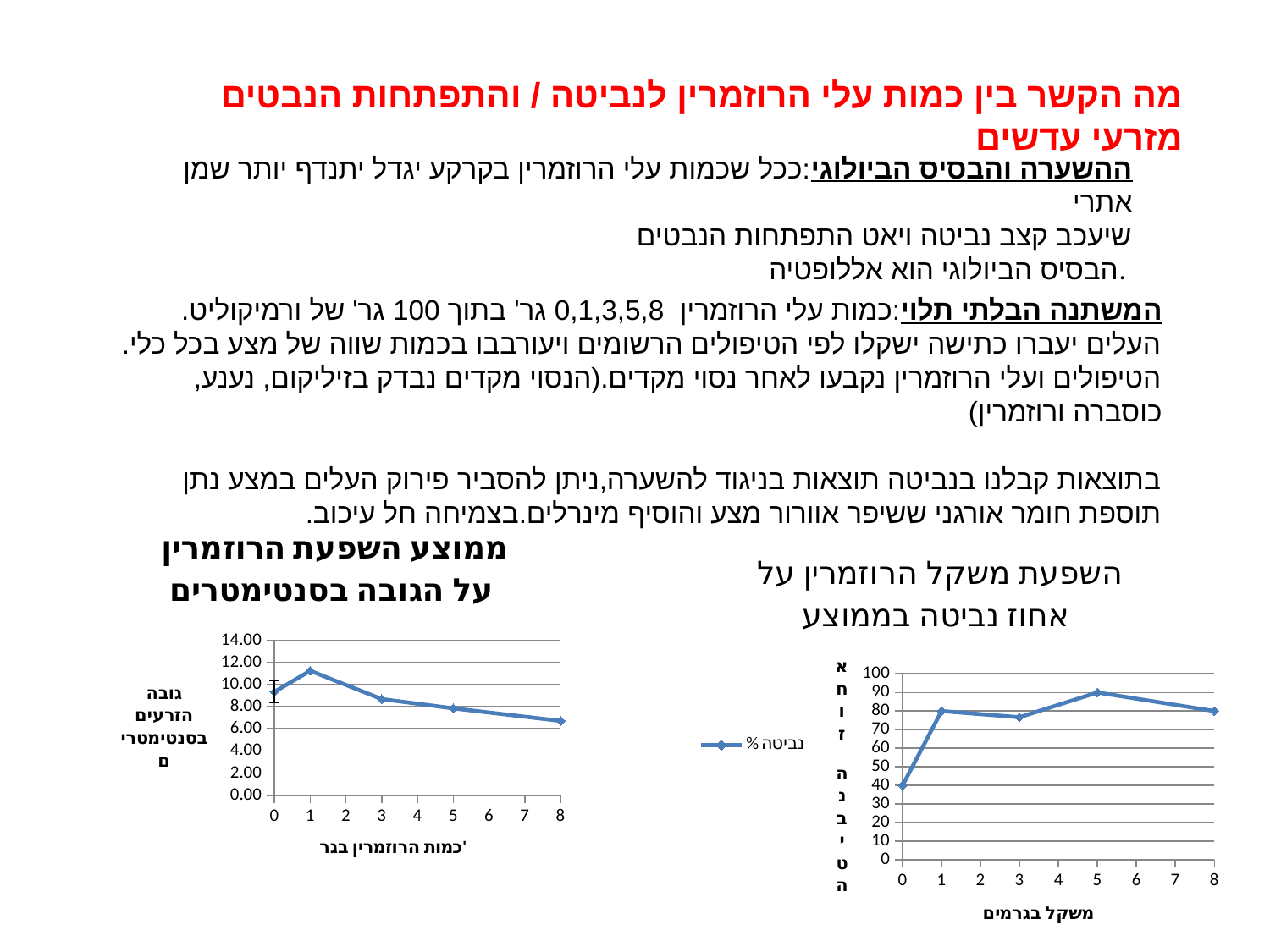
In the right-hand chart (germination percentage), at which rosemary weight is the germination percentage lowest? 0 In the left-hand chart (height in centimetres), at which rosemary amount is the height lowest? 8 In the left-hand chart (height in centimetres), is the value at rosemary amount 1 greater or less than 10.00? greater In the left-hand chart (height in centimetres), at which rosemary amount is the height highest? 1 In the left-hand chart (height in centimetres), do the values rise or fall from rosemary amount 1 to 8? fall In the right-hand chart (germination percentage), at which rosemary weight is the germination percentage highest? 5 In the right-hand chart (germination percentage), what is the germination percentage at rosemary weight 0 grams? 40 In the right-hand chart (germination percentage), how many series does the legend list? 1 In the right-hand chart (germination percentage), what is the germination percentage at rosemary weight 5 grams? 90 What kind of chart is the left-hand chart titled 'ממוצע השפעת הרוזמרין על הגובה בסנטימטרים'? line chart What kind of chart is the right-hand chart titled 'השפעת משקל הרוזמרין על אחוז נביטה בממוצע'? line chart In the right-hand chart (germination percentage), how many data points are plotted? 5